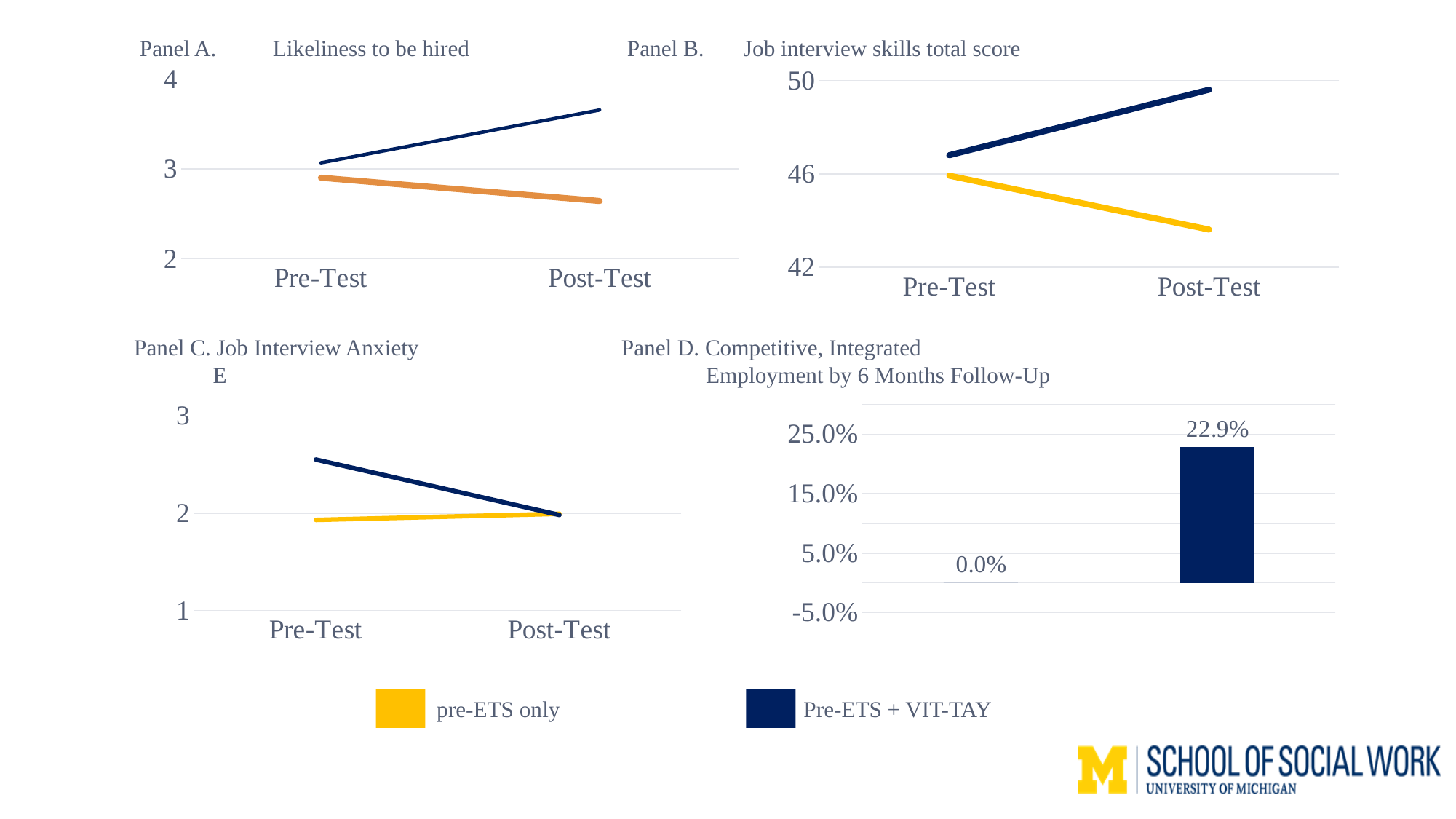
In Panel B (Job interview skills total score), is the Post-Test value for pre-ETS only greater or less than 46? less How many series does the legend at the bottom of the slide list? 2 In Panel A (Likeliness to be hired), which series has the higher value at Post-Test? Pre-ETS + VIT-TAY In Panel D (Competitive, Integrated Employment by 6 Months Follow-Up), what is the value for Pre-ETS + VIT-TAY? 22.9% In Panel A (Likeliness to be hired), does the Pre-ETS + VIT-TAY line rise or fall from Pre-Test to Post-Test? rise In Panel A (Likeliness to be hired), is the Post-Test value for Pre-ETS + VIT-TAY greater or less than 3? greater In Panel D (Competitive, Integrated Employment by 6 Months Follow-Up), what is the value for pre-ETS only? 0.0% What kind of chart is Panel A (Likeliness to be hired)? line chart In Panel B (Job interview skills total score), does the pre-ETS only line rise or fall from Pre-Test to Post-Test? fall In Panel C (Job Interview Anxiety), does the Pre-ETS + VIT-TAY line rise or fall from Pre-Test to Post-Test? fall In Panel D, what is the difference between the Pre-ETS + VIT-TAY value and the pre-ETS only value? 22.9% What kind of chart is Panel D? bar chart